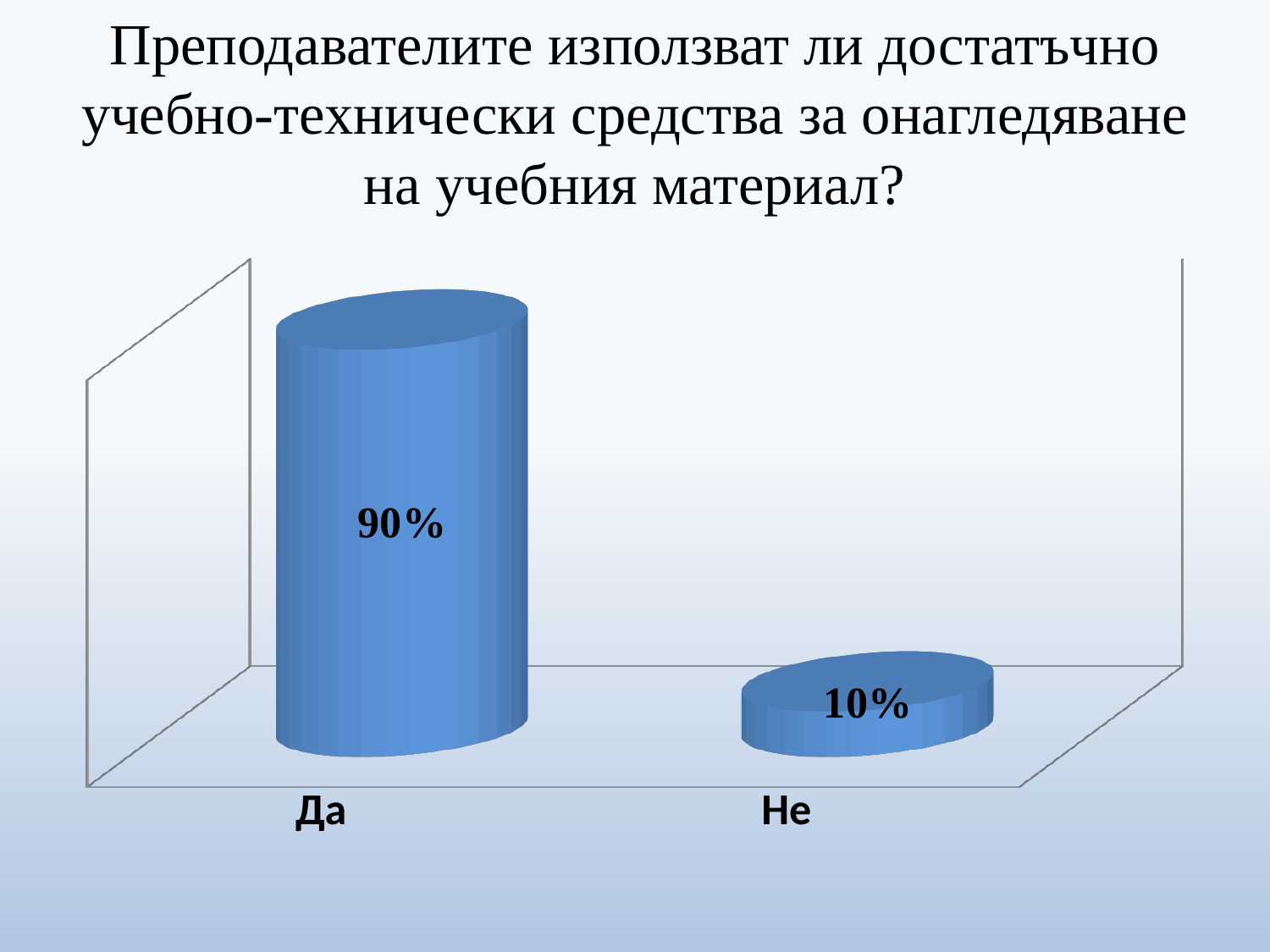
Which category has the highest value? Да Which is larger, the value for Да or the value for Не? Да What kind of chart is shown on the slide? Bar chart What is the title of the slide? Преподавателите използват ли достатъчно учебно-технически средства за онагледяване на учебния материал? What colour are the bars on the chart? Blue Which category has the lowest value? Не Do the values rise or fall from Да to Не? Fall What is the total of the two values shown on the chart? 100% How many categories are shown on the chart? 2 What is the difference between the values for Да and Не? 80% What is the value for Да? 90% What is the value for Не? 10%